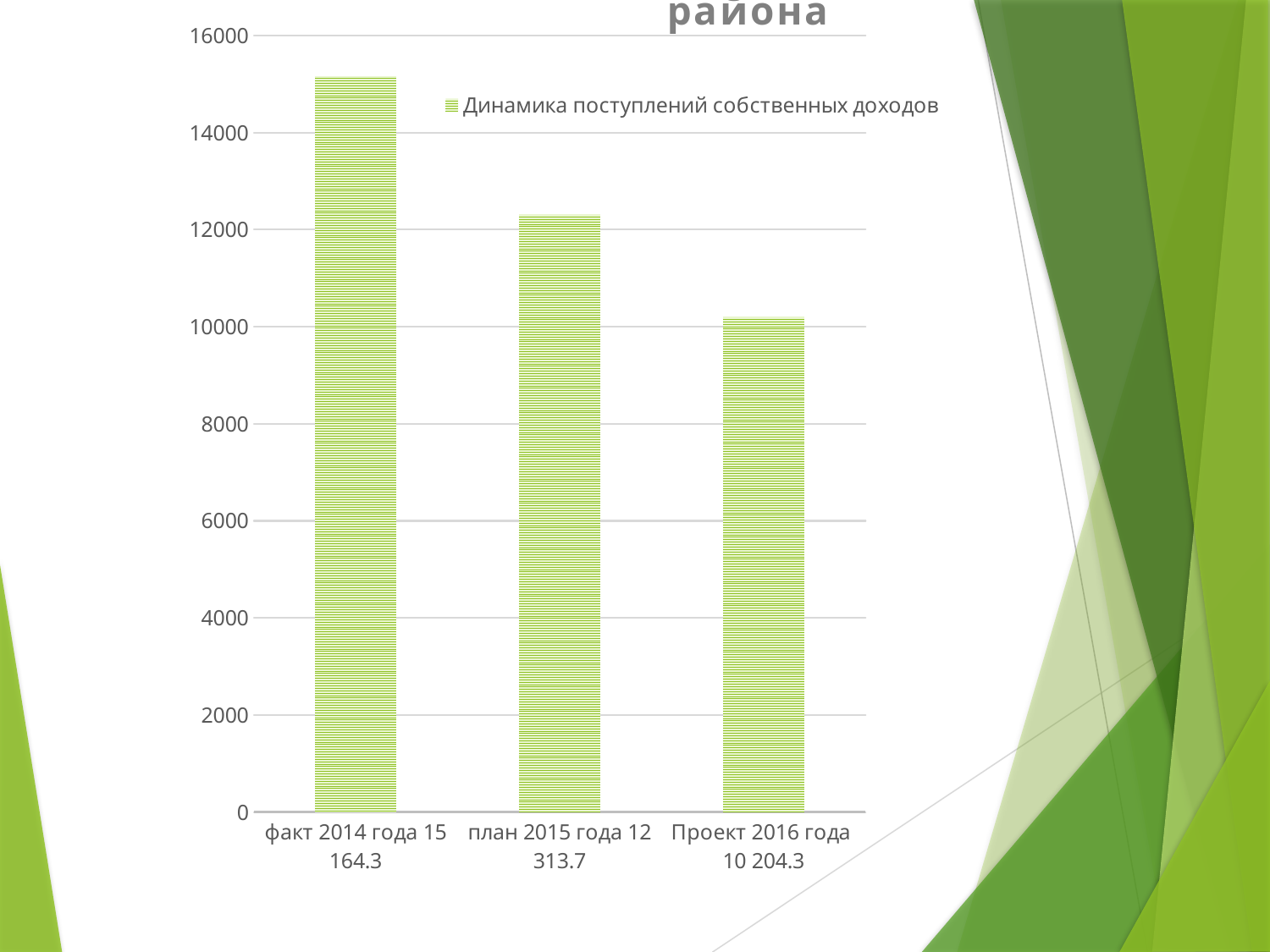
What is the name of the series shown in the legend? Динамика поступлений собственных доходов Which category has the highest bar? факт 2014 года What value is given for Проект 2016 года? 10 204.3 Is the value for план 2015 года greater or less than 12000? greater What value is given for план 2015 года? 12 313.7 Which is larger, the value for факт 2014 года or the value for Проект 2016 года? факт 2014 года Do the values rise or fall from left to right along the x axis? fall What value is given for факт 2014 года? 15 164.3 How many series does the legend list? 1 What kind of chart is shown on the slide? bar chart Which category has the lowest bar? Проект 2016 года How many bars does the chart have? 3